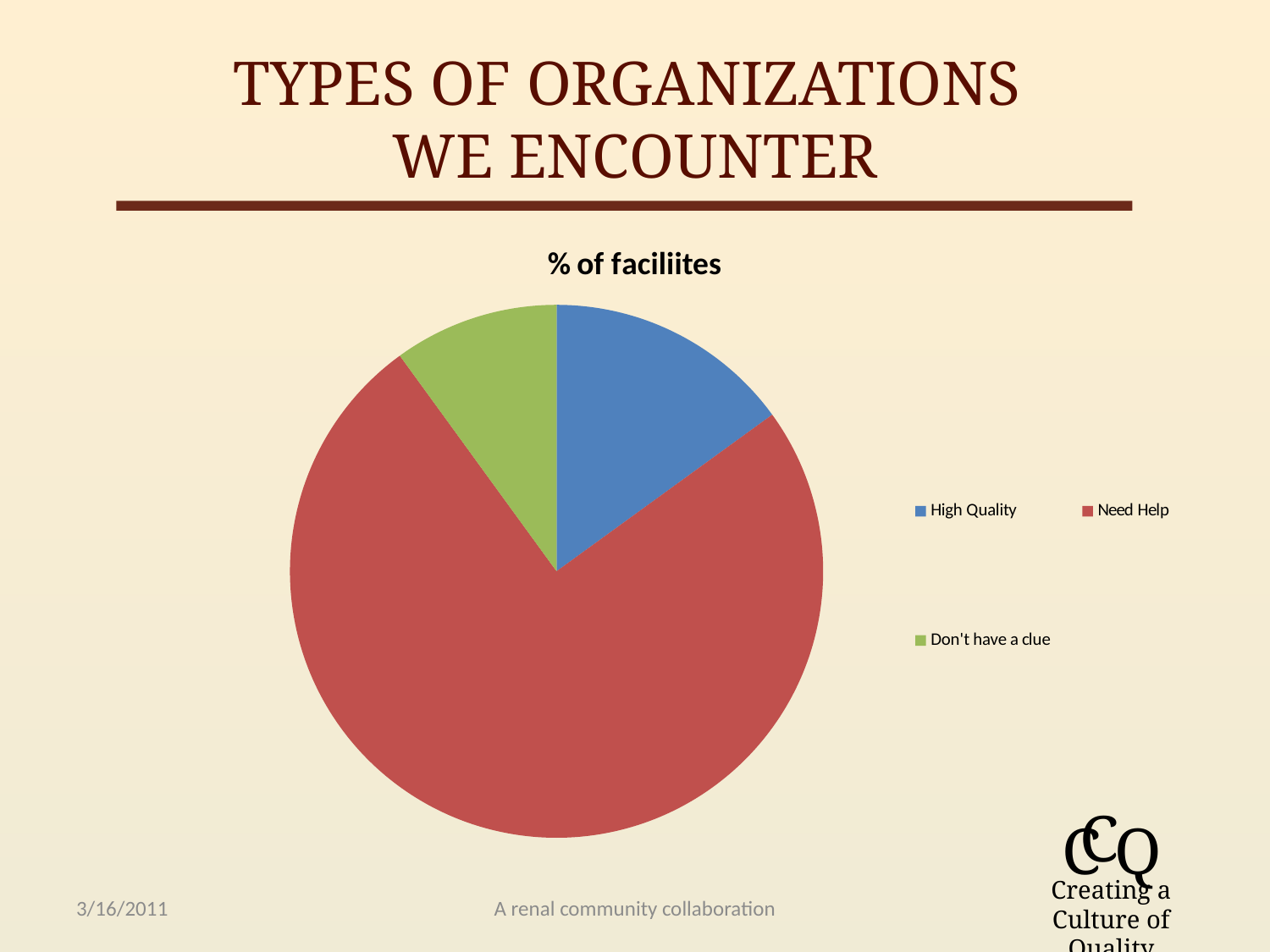
Which slice is larger, Need Help or Don't have a clue? Need Help What colour is the Need Help slice? red How many entries does the legend list? 3 Which slice is larger, High Quality or Don't have a clue? High Quality Which category has the largest slice of the pie? Need Help What kind of chart is shown on the slide? pie chart How many slices does the pie chart have? 3 Does the Need Help slice take up more or less than half of the pie? more Which category has the smallest slice of the pie? Don't have a clue What is the title of the chart? % of faciliites